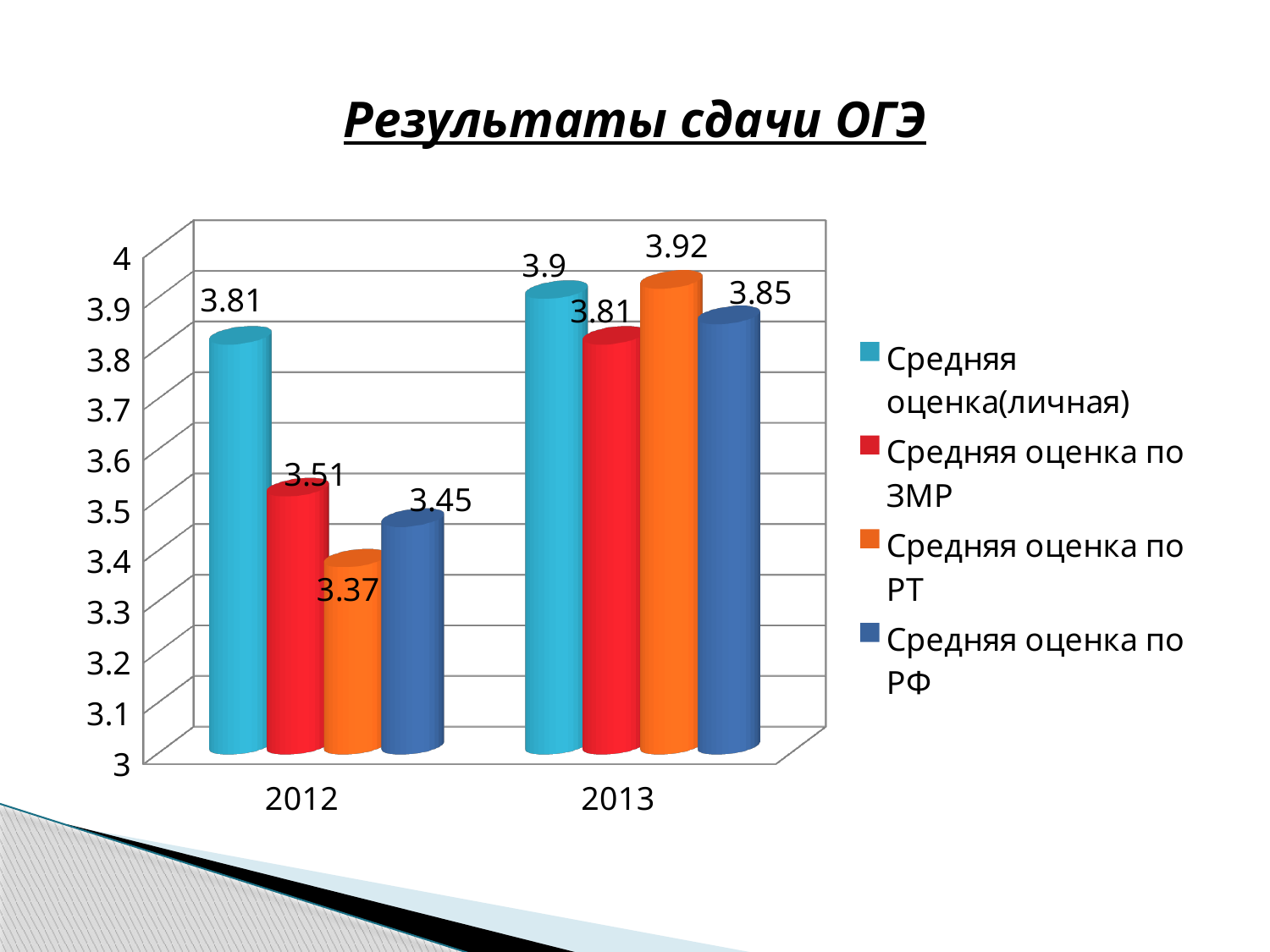
What is the value of Средняя оценка по ЗМР for 2013? 3.81 Which series has the lowest value in 2012? Средняя оценка по РТ What kind of chart is shown on the slide? Bar chart How many series does the legend list? 4 Which series has the highest value in 2013? Средняя оценка по РТ What is the title of the slide? Результаты сдачи ОГЭ What is the value of Средняя оценка(личная) for 2012? 3.81 What is the difference between Средняя оценка по РТ in 2013 and in 2012? 0.55 What is the value of Средняя оценка по РТ for 2013? 3.92 Which is larger in 2012: Средняя оценка по ЗМР or Средняя оценка по РФ? Средняя оценка по ЗМР How many categories are shown on the x axis? 2 What is the value of Средняя оценка по РФ for 2012? 3.45